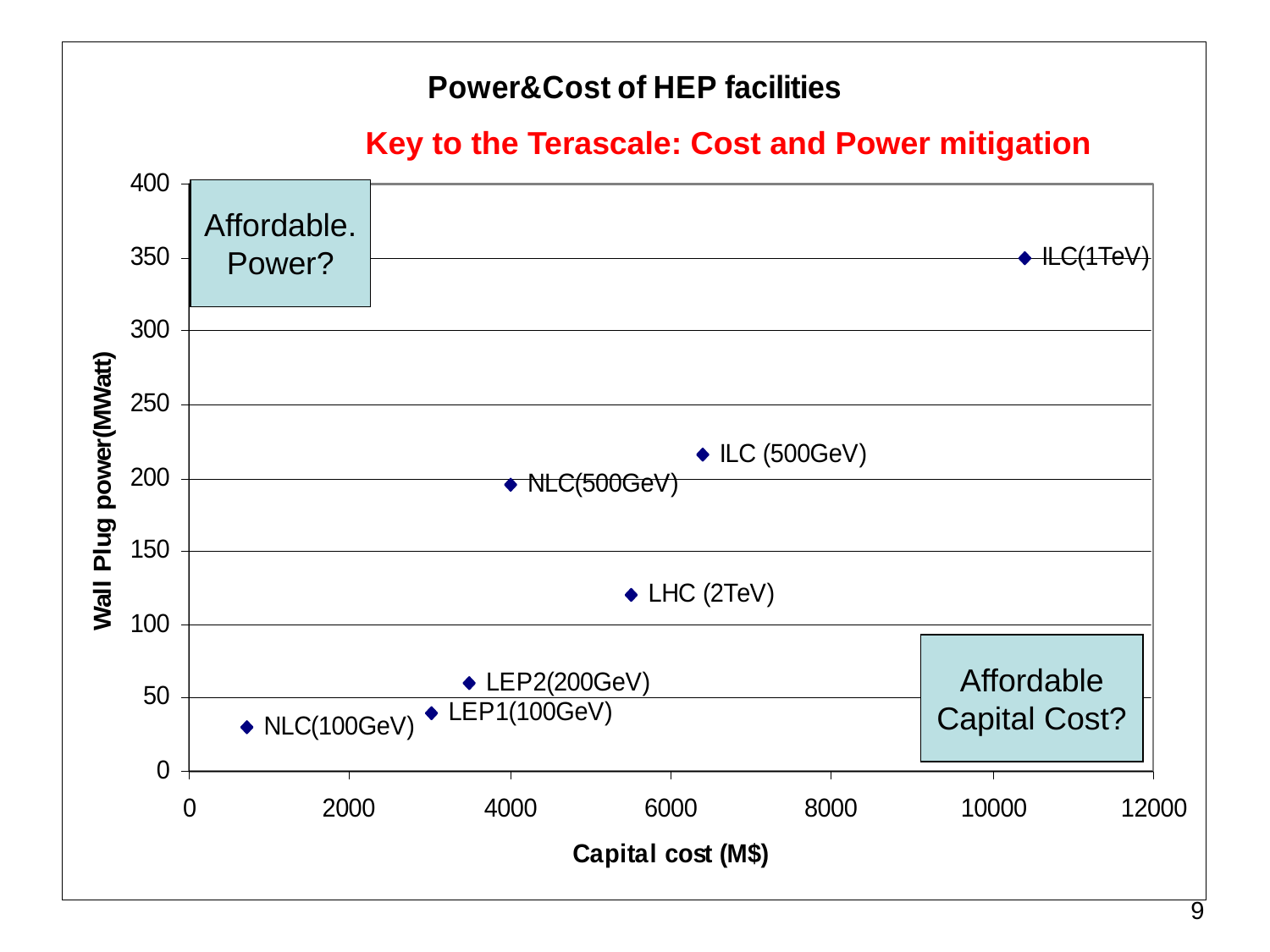
Which has the higher wall plug power, ILC (500GeV) or NLC(500GeV)? ILC (500GeV) Which facility has the highest wall plug power? ILC(1TeV) Which facility has the highest capital cost? ILC(1TeV) Is the wall plug power for ILC(1TeV) greater or less than 300 MWatt? greater What is the label of the x axis? Capital cost (M$) Is the wall plug power for LHC (2TeV) greater or less than 150 MWatt? less What kind of chart is shown on the slide? scatter chart Which facility has the lowest capital cost? NLC(100GeV) How many facilities are plotted on the chart? 7 Which facility has the lowest wall plug power? NLC(100GeV) Is the capital cost for ILC (500GeV) greater or less than 6000 M$? greater Which has the higher capital cost, LHC (2TeV) or LEP2(200GeV)? LHC (2TeV)